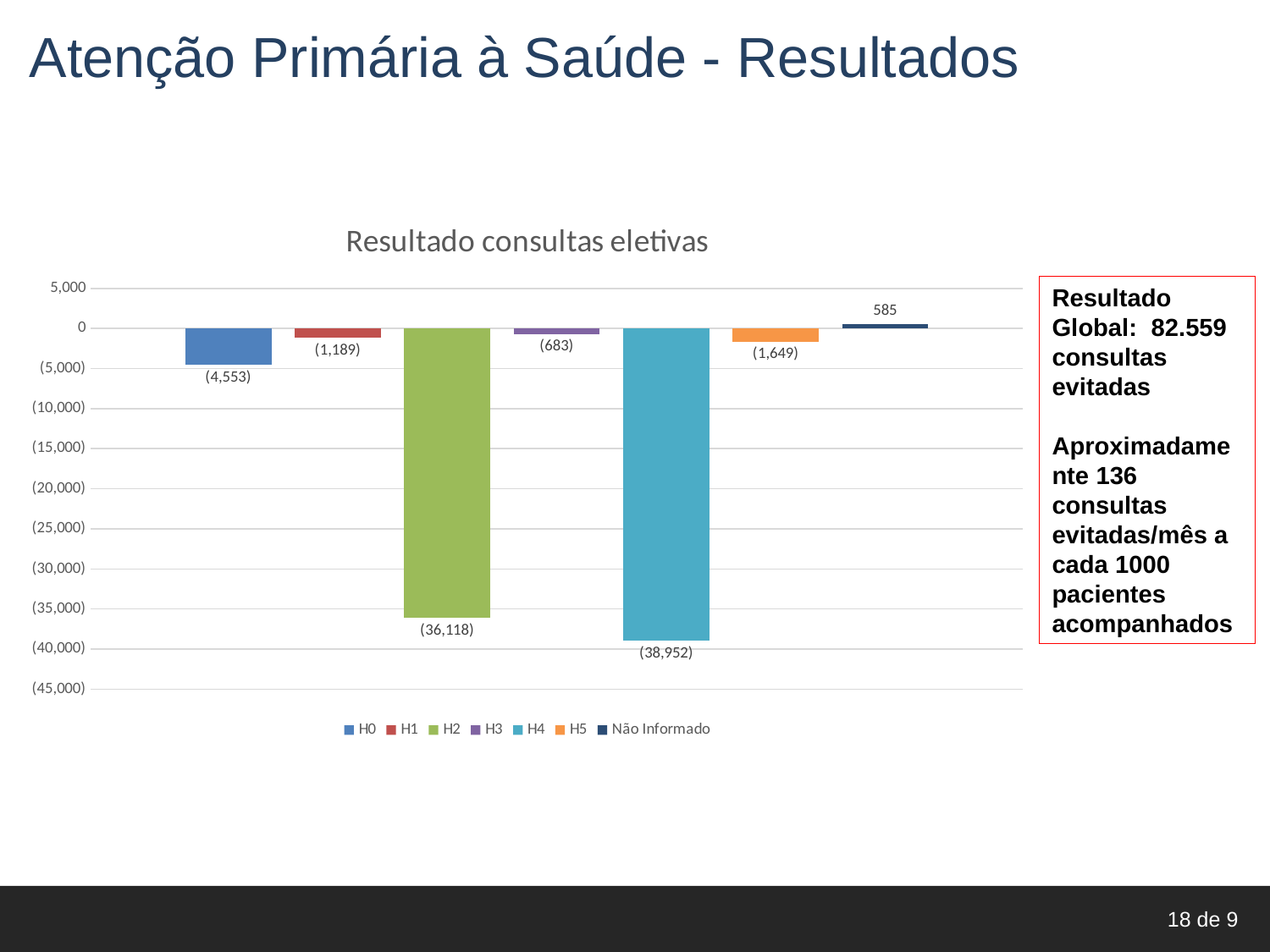
What is the value shown for H4 in the 'Resultado consultas eletivas' chart? (38,952) By how much does the magnitude of the H4 value exceed the magnitude of the H2 value in the 'Resultado consultas eletivas' chart? 2,834 How many series does the legend of the 'Resultado consultas eletivas' chart list? 7 What kind of chart is 'Resultado consultas eletivas'? Bar chart What is the value shown for 'Não Informado' in the 'Resultado consultas eletivas' chart? 585 What is the value shown for H3 in the 'Resultado consultas eletivas' chart? (683) What is the value shown for H0 in the 'Resultado consultas eletivas' chart? (4,553) Which series is the only one with a positive value in the 'Resultado consultas eletivas' chart? Não Informado Which bar extends further below zero in the 'Resultado consultas eletivas' chart, H0 or H1? H0 What is the title of the chart on the slide? Resultado consultas eletivas What is the value shown for H2 in the 'Resultado consultas eletivas' chart? (36,118) Which series has the lowest (most negative) value in the 'Resultado consultas eletivas' chart? H4